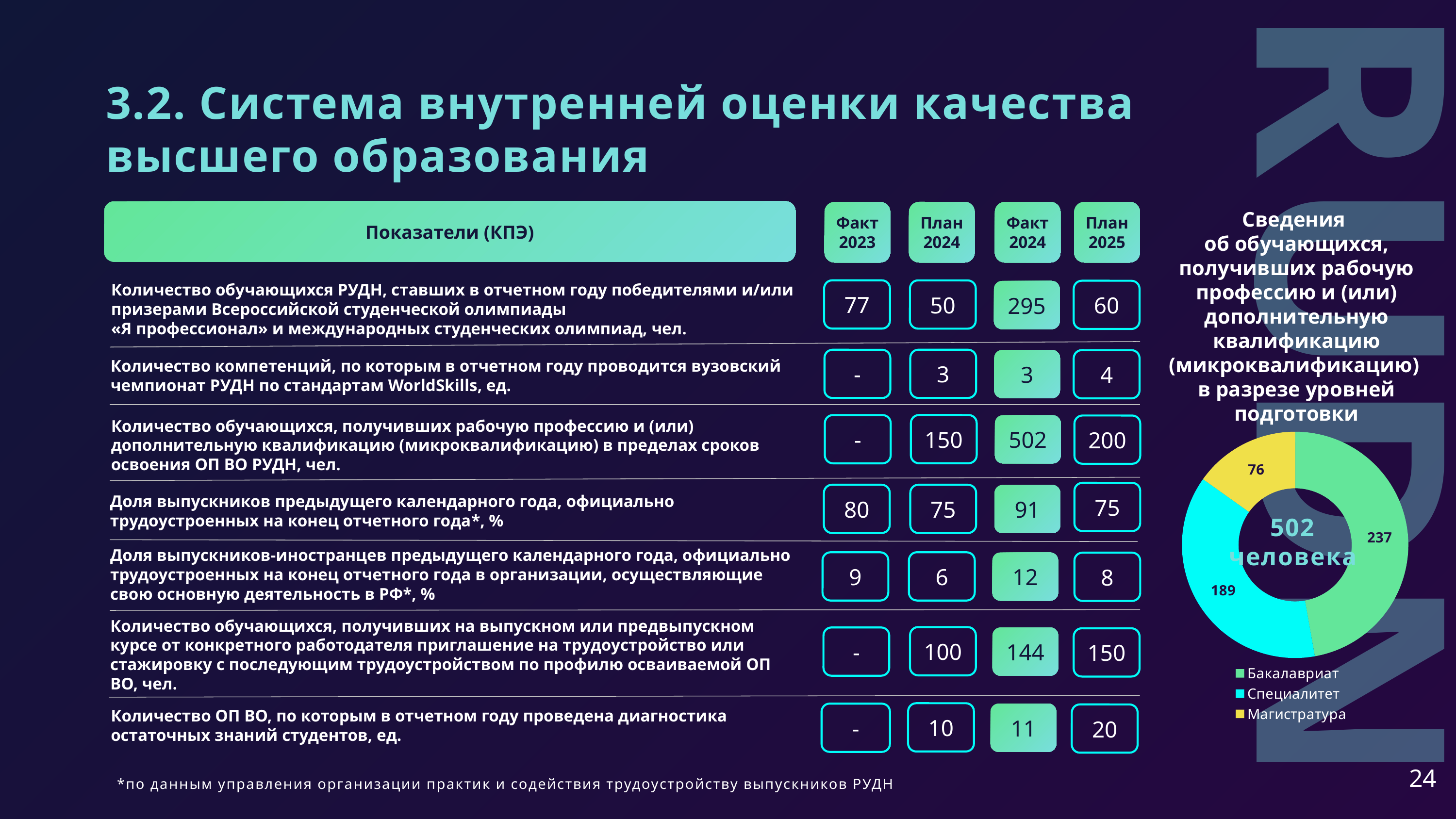
Which category has the largest slice in the pie chart? Бакалавриат What is the difference between the Бакалавриат and Специалитет values in the pie chart? 48 In the pie chart, which is larger: Специалитет or Магистратура? Специалитет What is the value for Бакалавриат in the pie chart? 237 What total number of people is shown in the centre of the pie chart? 502 человека What is the value for Специалитет in the pie chart? 189 What colour is the Магистратура slice in the pie chart? yellow How many categories does the pie chart show? 3 What is the difference between the Специалитет and Магистратура values in the pie chart? 113 What is the value for Магистратура in the pie chart? 76 What kind of chart is shown on the right of the slide? pie chart (donut) Which category has the smallest slice in the pie chart? Магистратура